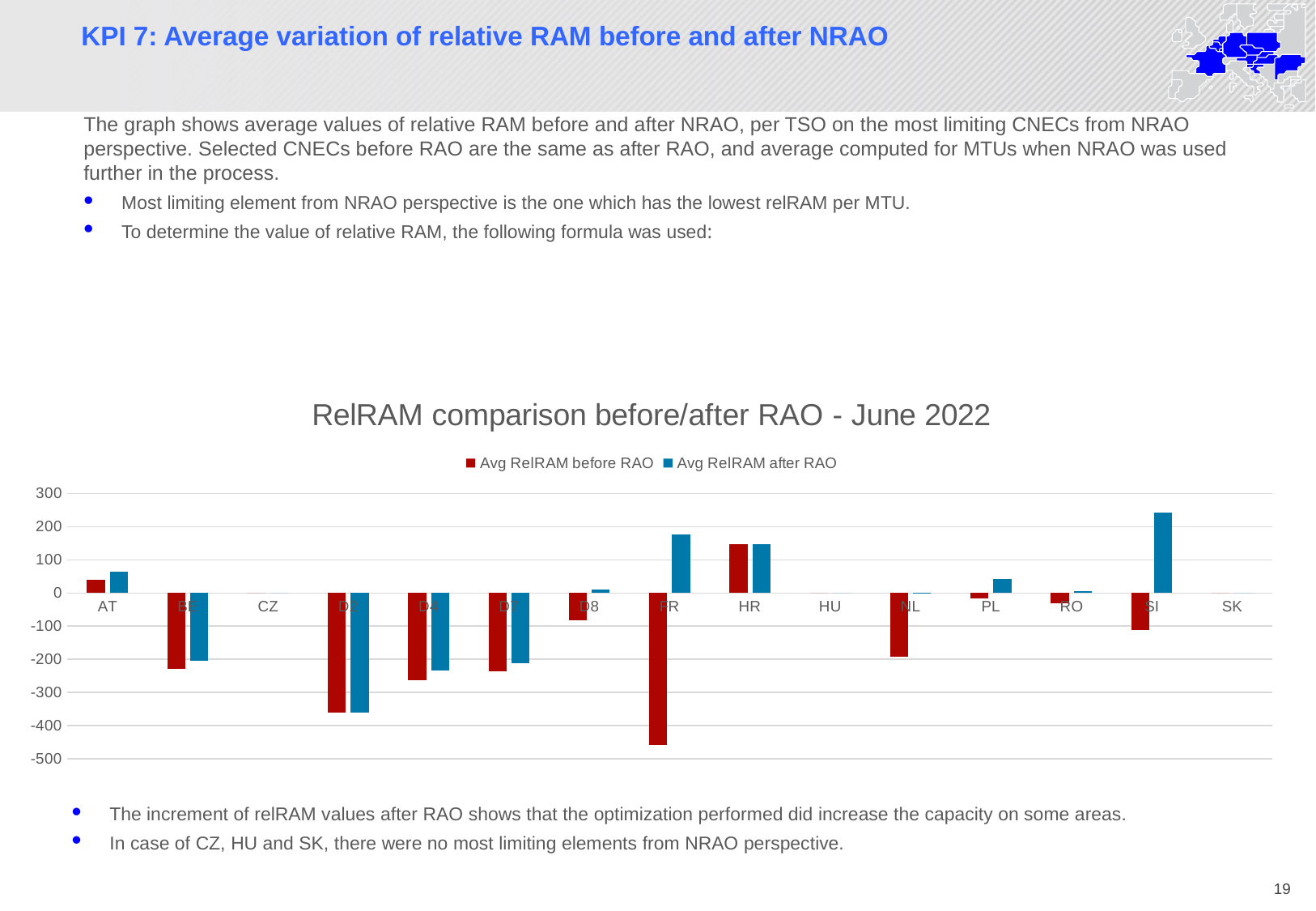
What type of chart is shown on the slide? Bar chart For AT, which is larger: Avg RelRAM before RAO or Avg RelRAM after RAO? Avg RelRAM after RAO Is the Avg RelRAM before RAO value for FR greater or less than -400? less Is the Avg RelRAM after RAO value for SI greater or less than 200? greater What is the title of the chart on the slide? RelRAM comparison before/after RAO - June 2022 Which category has the highest Avg RelRAM after RAO value? SI Which series is shown in red in the RelRAM comparison chart? Avg RelRAM before RAO How many series does the legend of the RelRAM comparison chart list? 2 Is the Avg RelRAM before RAO value for HR greater or less than 100? greater How many categories are shown on the x axis of the RelRAM comparison chart? 15 Which category has the lowest Avg RelRAM before RAO value? FR